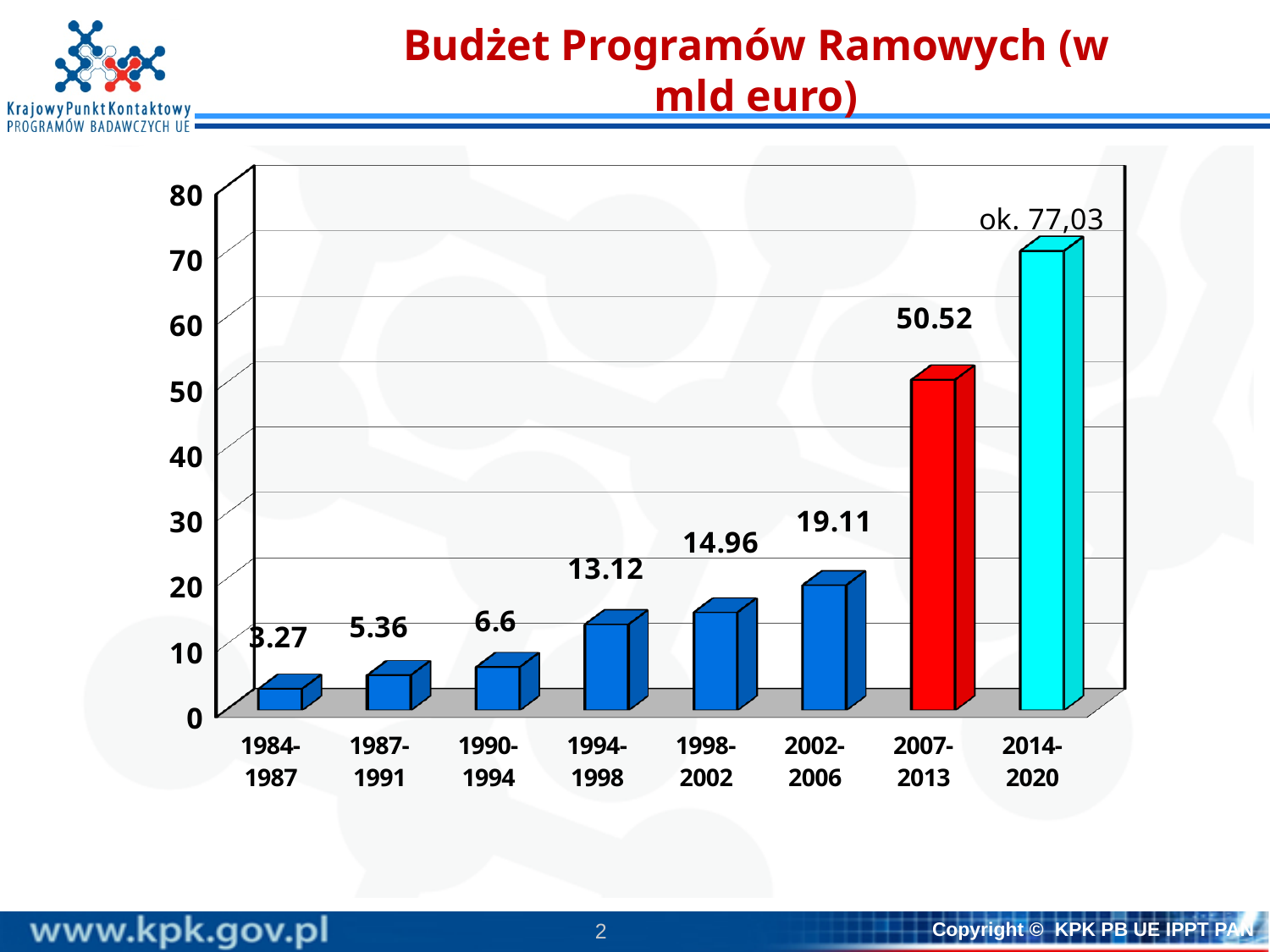
What is the value for 2002-2006? 19.11 Which period has the lowest value? 1984-1987 What is the value for 1994-1998? 13.12 What is the difference between the values for 2007-2013 and 2002-2006? 31.41 What kind of chart is shown on the slide? bar chart Which is larger, the value for 1998-2002 or the value for 1990-1994? 1998-2002 How many periods are shown on the x axis? 8 What is the value for 2007-2013? 50.52 Which period has the highest value? 2014-2020 What is the value for 1984-1987? 3.27 What is the difference between the values for 1987-1991 and 1984-1987? 2.09